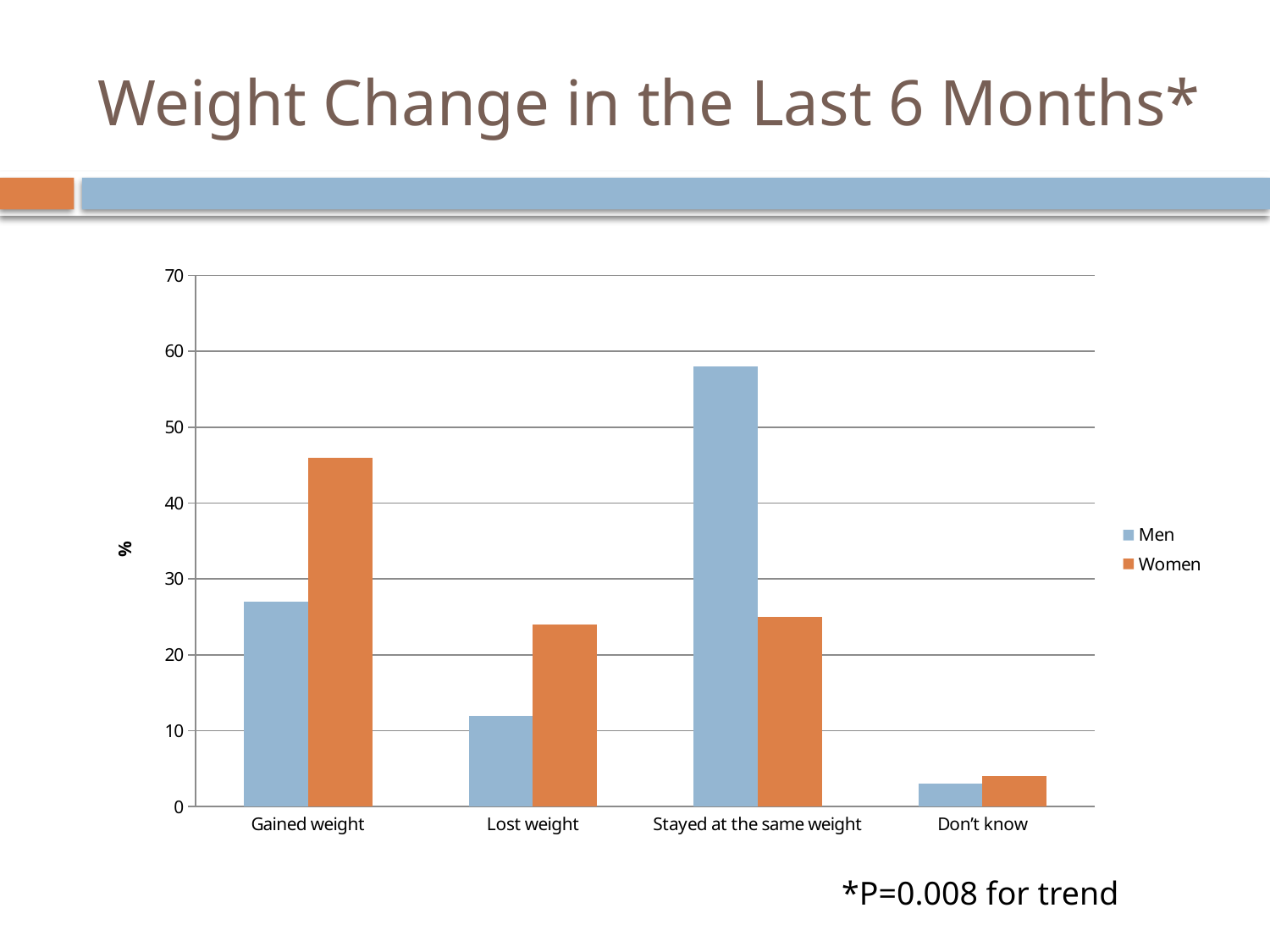
What is the title of the chart on the slide? Weight Change in the Last 6 Months* Which category has the highest value for Women? Gained weight For Gained weight, which is larger, the value for Men or for Women? Women Which category has the lowest value for Women? Don't know Which category has the highest value for Men? Stayed at the same weight Is the value for Women in Lost weight greater or less than 30? less Is the value for Men in Stayed at the same weight greater or less than 50? greater How many categories are shown on the x axis? 4 What kind of chart is shown on the slide? bar chart For Stayed at the same weight, which is larger, the value for Men or for Women? Men Which category has the lowest value for Men? Don't know How many series does the legend list? 2